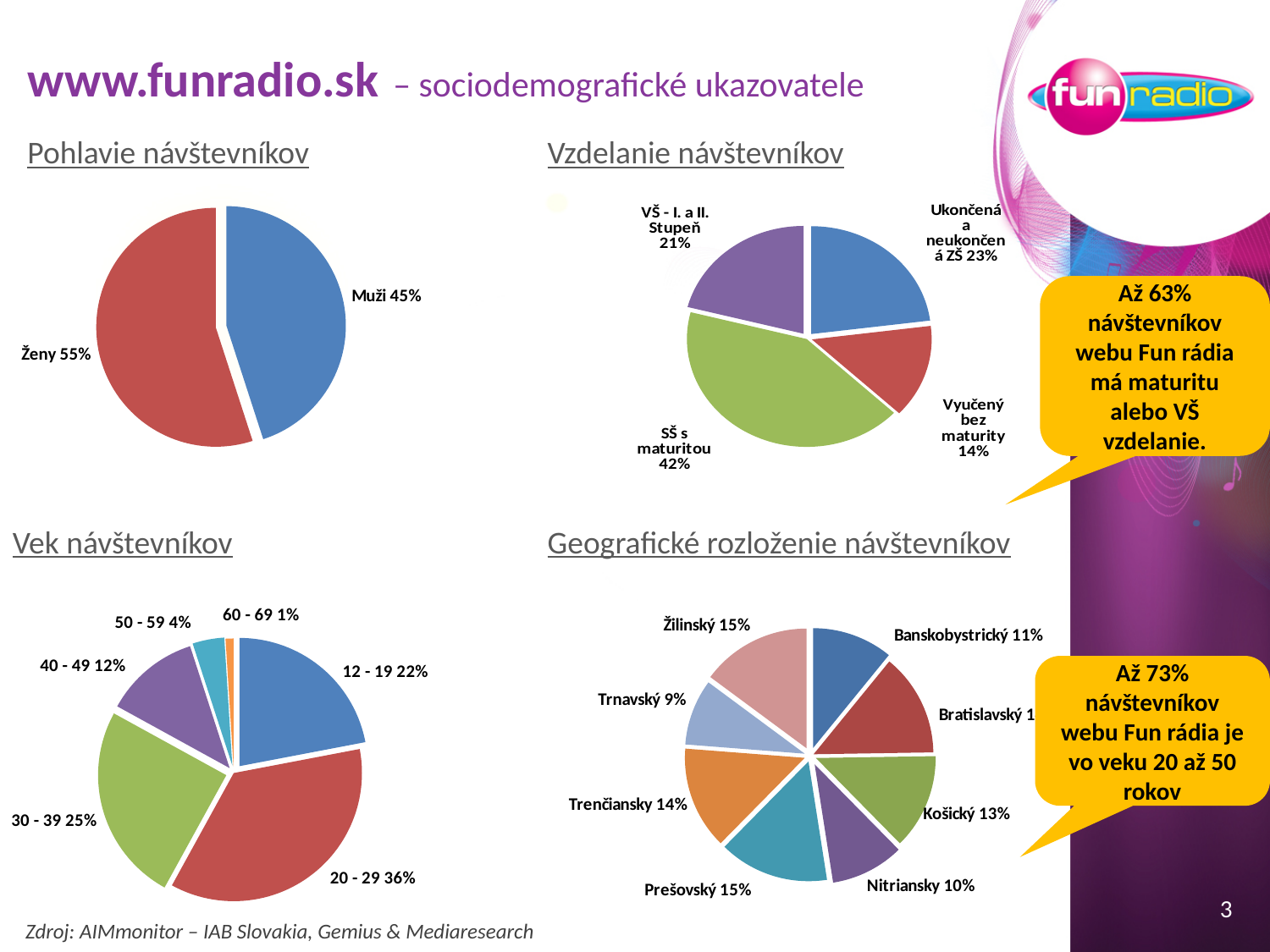
In the 'Vzdelanie návštevníkov' chart, which education category has the smallest share? Vyučený bez maturity In the 'Vek návštevníkov' chart, what is the share of the 60 - 69 age group? 1% What type of chart is used for 'Vzdelanie návštevníkov'? Pie chart In the 'Vzdelanie návštevníkov' chart, what is the share for 'SŠ s maturitou'? 42% In the 'Vek návštevníkov' chart, which age group has the largest share? 20 - 29 In the 'Pohlavie návštevníkov' chart, what share of visitors are women (Ženy)? 55% In the 'Geografické rozloženie návštevníkov' chart, what is the share for Košický? 13% In the 'Vzdelanie návštevníkov' chart, what is the difference between 'SŠ s maturitou' and 'VŠ - I. a II. stupeň'? 21 percentage points In the 'Vek návštevníkov' chart, what is the combined share of the 30 - 39 and 40 - 49 age groups? 37% How many categories are shown in the 'Vek návštevníkov' chart? 6 In the 'Geografické rozloženie návštevníkov' chart, which is larger, Trenčiansky or Trnavský? Trenčiansky In the 'Pohlavie návštevníkov' chart, which group is larger, Muži or Ženy? Ženy